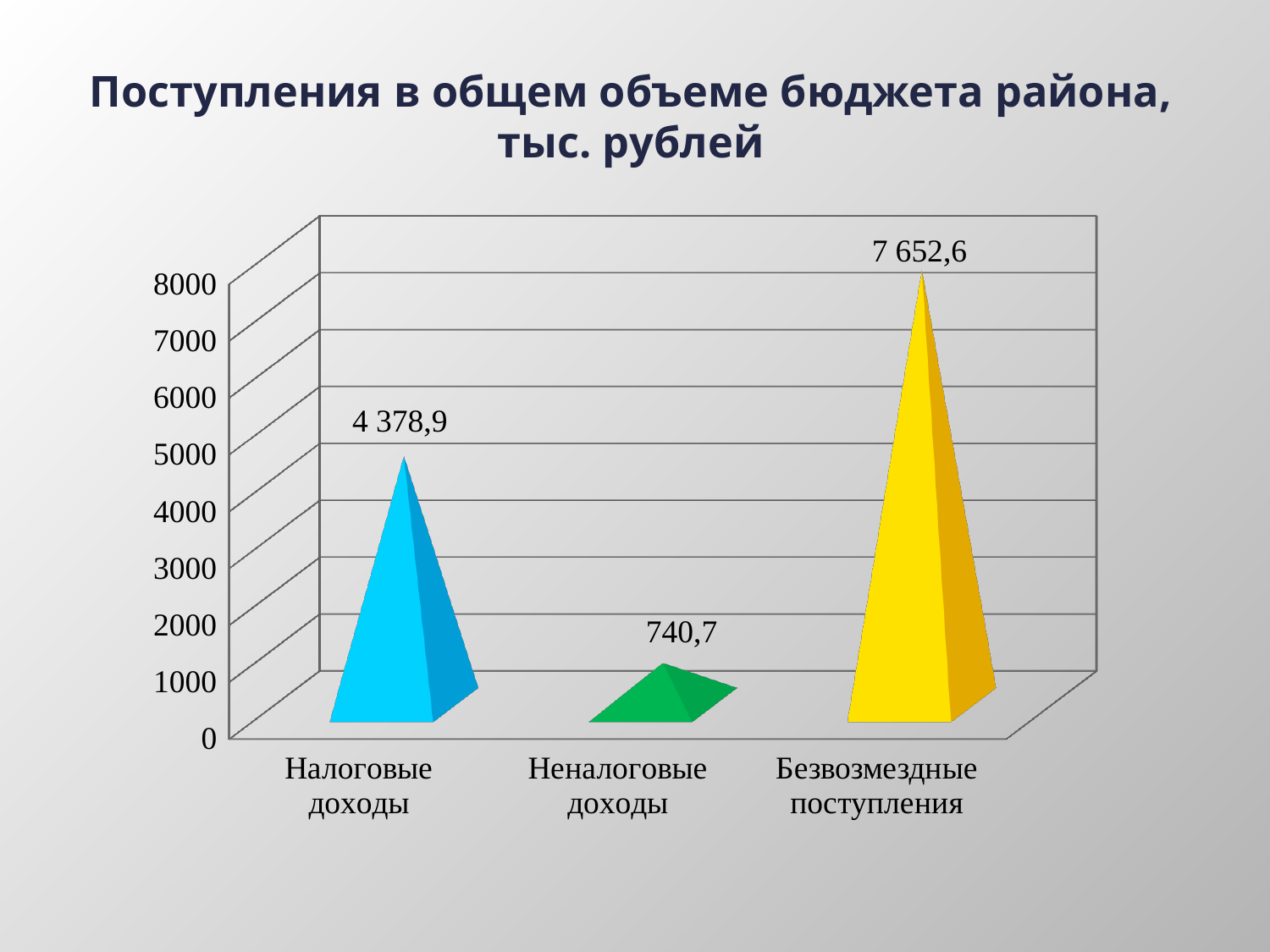
What is the value for Налоговые доходы? 4 378,9 Which is larger, the value for Налоговые доходы or the value for Неналоговые доходы? Налоговые доходы What is the title of the chart? Поступления в общем объеме бюджета района, тыс. рублей How many categories are shown on the x axis? 3 What is the value for Неналоговые доходы? 740,7 Is the value for Налоговые доходы greater or less than 5000? less What is the difference between the values for Безвозмездные поступления and Налоговые доходы? 3 273,7 What is the value for Безвозмездные поступления? 7 652,6 What kind of chart is shown on the slide? bar chart Which category has the highest value? Безвозмездные поступления What is the difference between the values for Налоговые доходы and Неналоговые доходы? 3 638,2 Which category has the lowest value? Неналоговые доходы